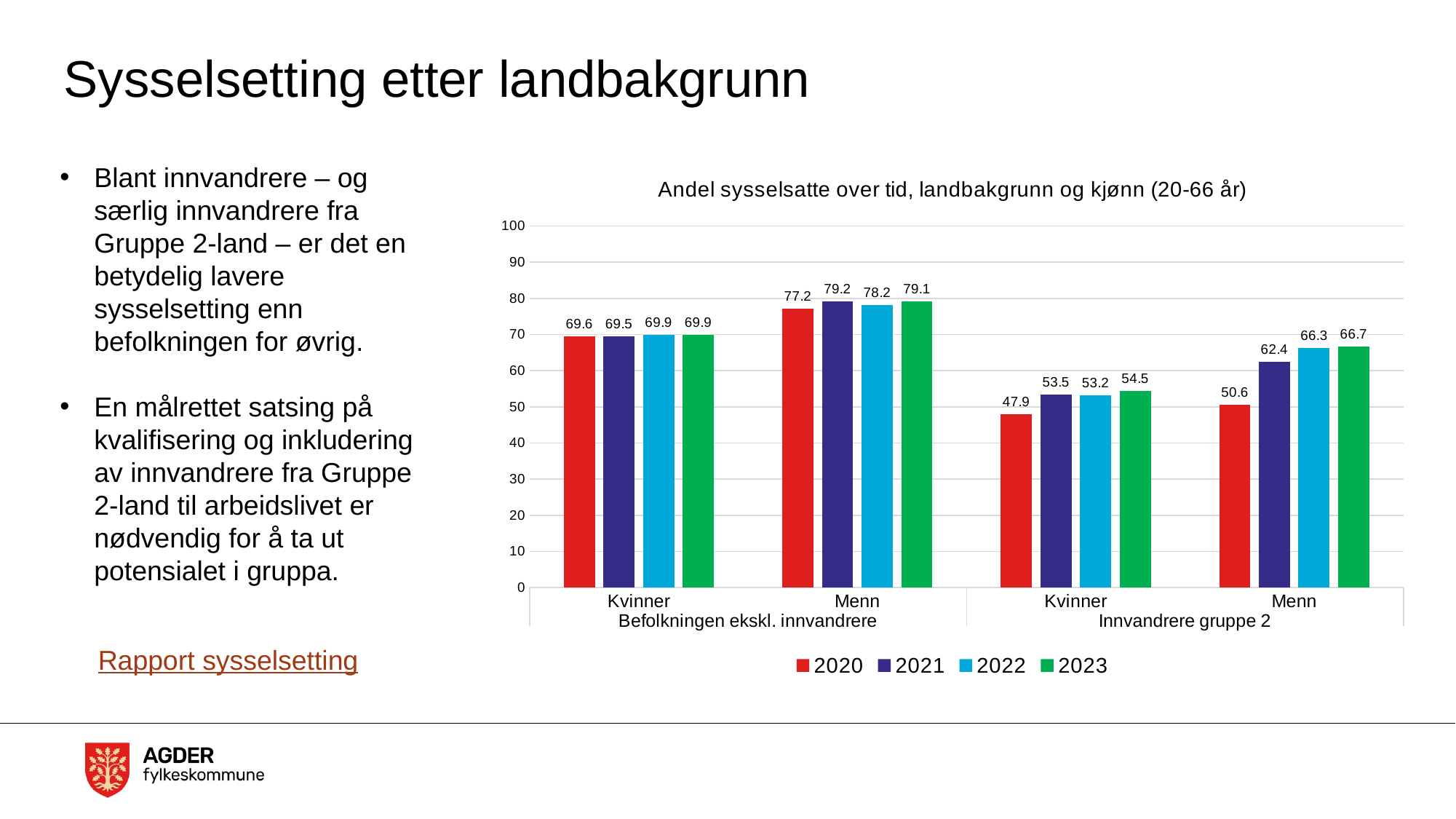
How many series does the legend list? 4 What is the difference between the 2023 and 2020 values for Menn in Innvandrere gruppe 2? 16.1 Which category has the highest value for 2021? Menn, Befolkningen ekskl. innvandrere What is the value for Kvinner in Innvandrere gruppe 2 for 2021? 53.5 What kind of chart is shown on the slide? Bar chart Which category has the lowest value for 2020? Kvinner, Innvandrere gruppe 2 What is the value for Menn in Befolkningen ekskl. innvandrere for 2022? 78.2 Which is larger: the 2022 value for Kvinner in Innvandrere gruppe 2 or the 2022 value for Menn in Innvandrere gruppe 2? Menn in Innvandrere gruppe 2 Do the values for Menn in Innvandrere gruppe 2 rise or fall from 2020 to 2023? Rise Is the 2020 value for Kvinner in Innvandrere gruppe 2 greater or less than 50? less What is the value for Menn in Innvandrere gruppe 2 for 2023? 66.7 What is the value for Kvinner in Befolkningen ekskl. innvandrere for 2020? 69.6